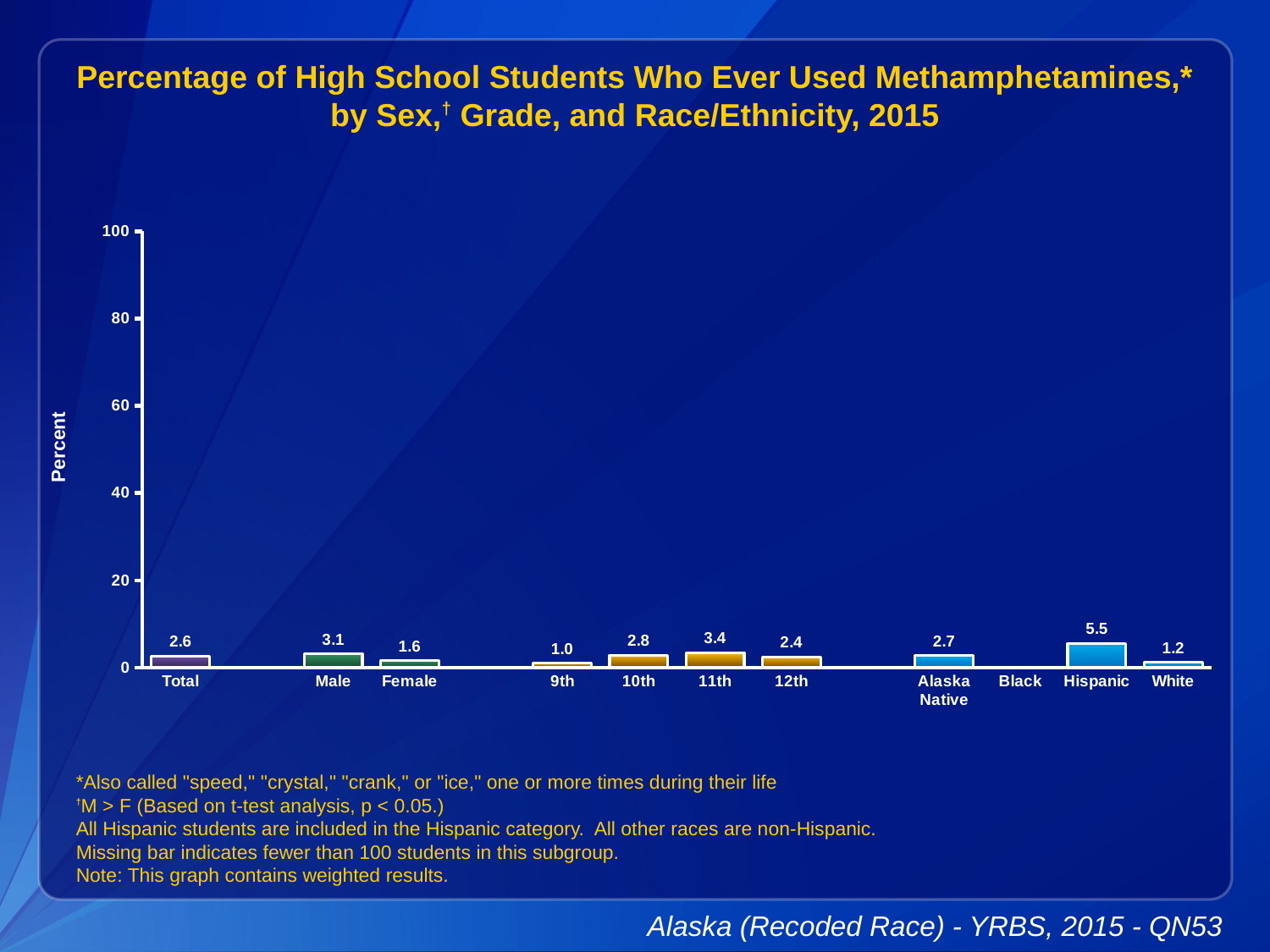
What kind of chart is shown? bar chart Which category has the highest value? Hispanic What is the value for Total? 2.6 What is the difference between the Male and Female values? 1.5 What is the value for Hispanic? 5.5 Is the value for Hispanic greater or less than 20? less How many categories have a bar shown on the chart? 11 Which category has the lowest labeled value? 9th Which category has no bar shown? Black What is the value for Male? 3.1 Which is larger, the value for 11th grade or 12th grade? 11th What is the value for 9th grade? 1.0